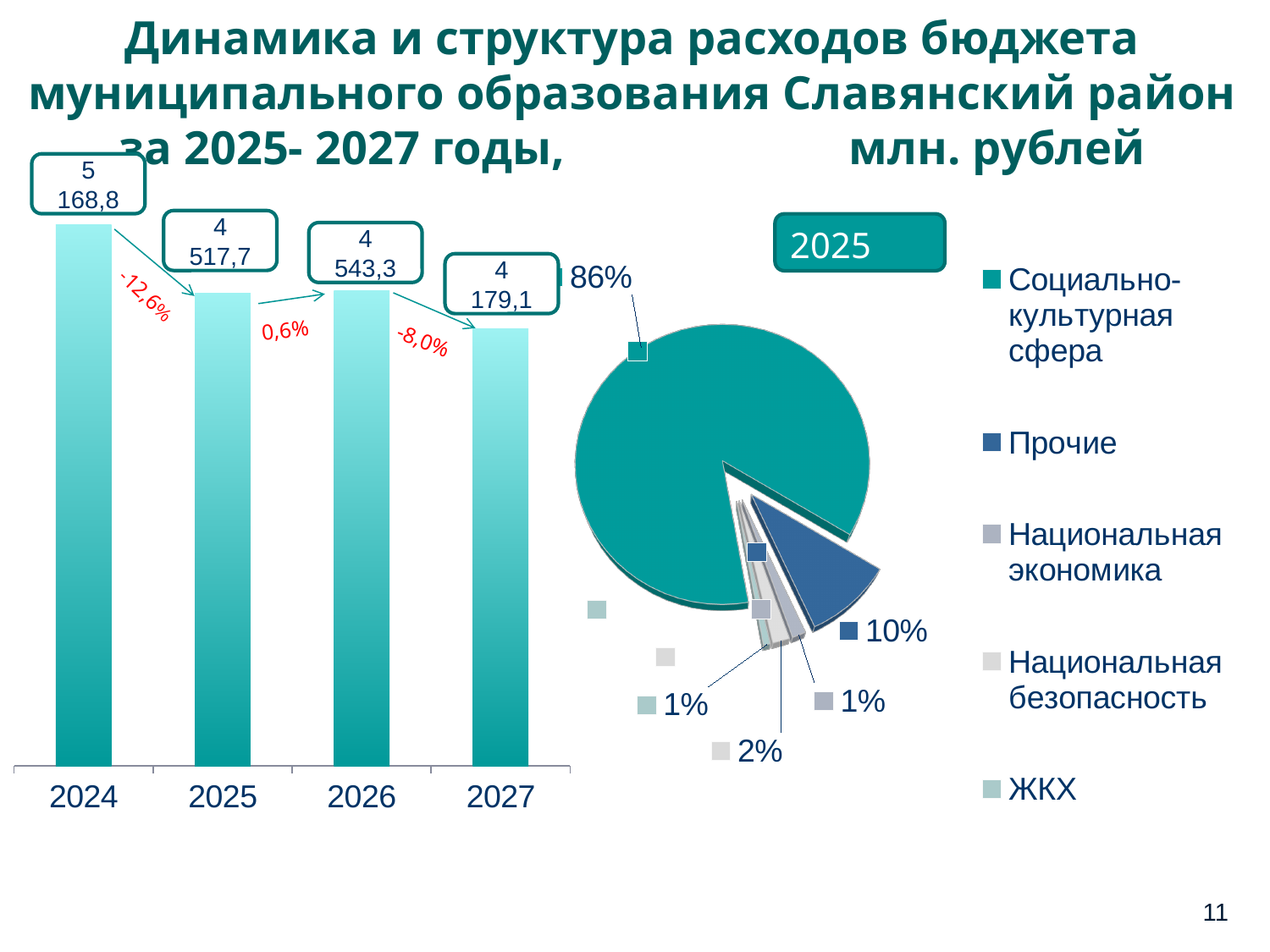
In the pie chart titled 2025, what share does Прочие have? 10% In the bar chart on the left, what is the value for 2024? 5 168,8 In the bar chart on the left, which year has the lowest value? 2027 How many categories does the legend of the pie chart titled 2025 list? 5 In the bar chart on the left, how many years are shown? 4 In the bar chart on the left, what is the value for 2027? 4 179,1 In the bar chart on the left, what is the difference between the values for 2026 and 2027? 364,2 In the pie chart titled 2025, what share does Социально-культурная сфера have? 86% What kind of chart is the chart on the left of the slide? Bar chart In the bar chart on the left, which year has the highest value? 2024 In the pie chart titled 2025, which category has the largest slice? Социально-культурная сфера In the bar chart on the left, what is the difference between the values for 2024 and 2025? 651,1